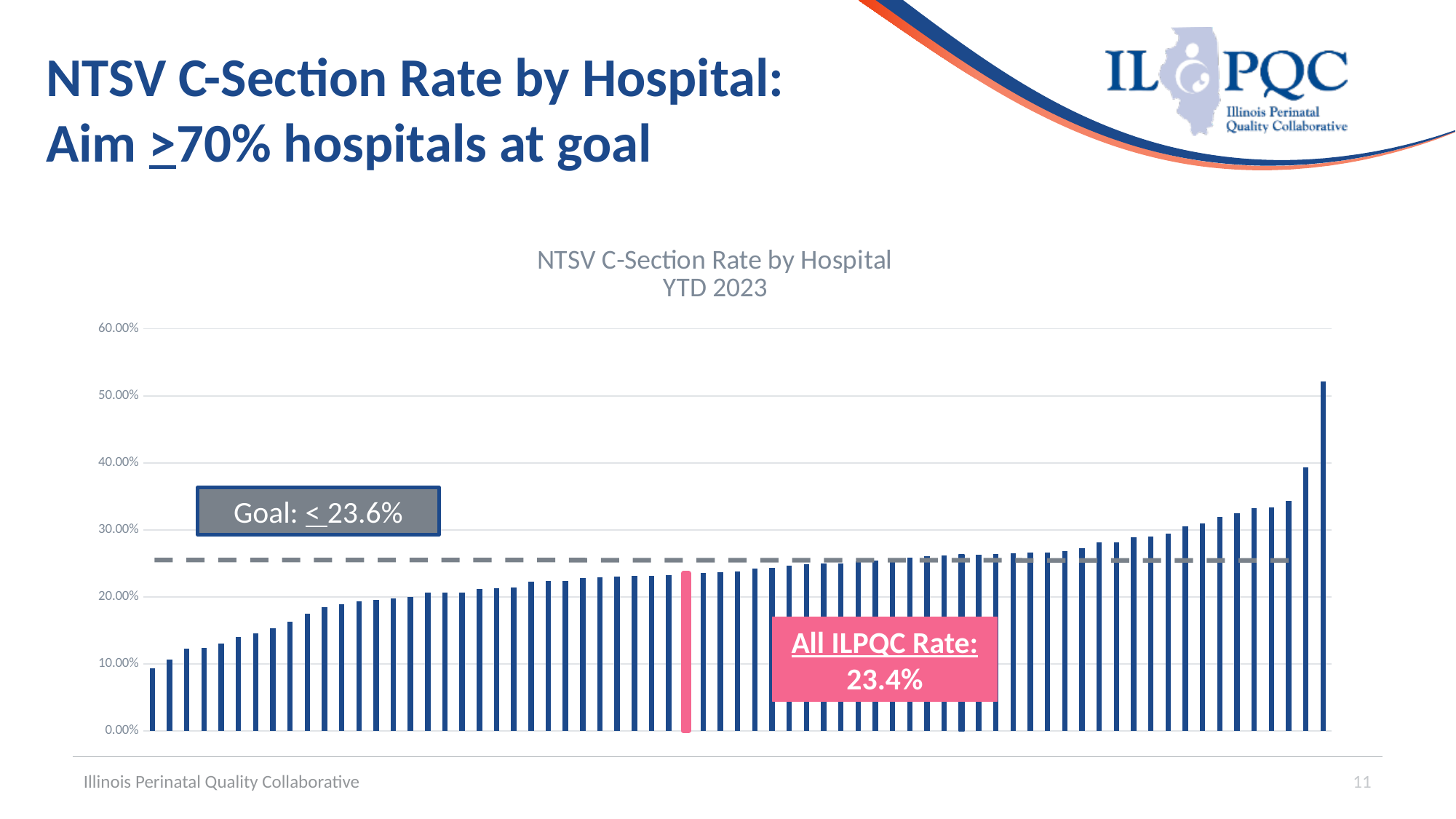
Is the value of the tallest bar (rightmost hospital) greater or less than 50.00%? greater What kind of chart is shown on the slide? Bar chart What is the title of the chart? NTSV C-Section Rate by Hospital YTD 2023 Is the value of the pink highlighted bar greater or less than 30.00%? less What goal value is shown in the grey box on the chart? ≤ 23.6% Is the value of the shortest bar (leftmost hospital) greater or less than 10.00%? less What is the highest value shown on the y axis? 60.00% Which bar is taller: the rightmost bar or the leftmost bar? The rightmost bar Do the bar values rise or fall from left to right along the x axis? Rise What is the All ILPQC Rate shown on the chart? 23.4%